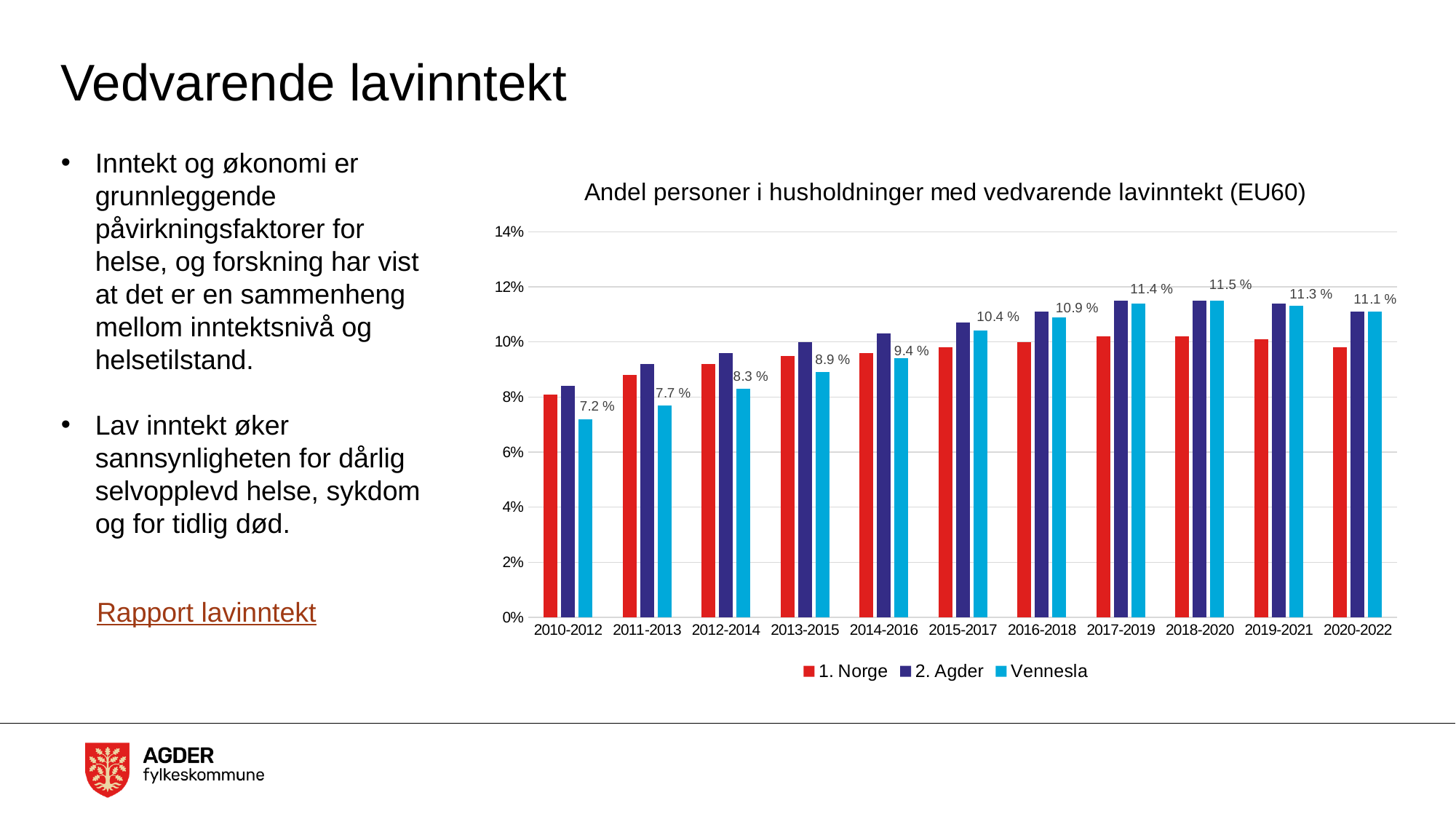
In which period is the Vennesla value highest? 2018-2020 What kind of chart is shown on the slide? bar chart What is the value for Vennesla in 2020-2022? 11.1 % In which period is the Vennesla value lowest? 2010-2012 What is the value for Vennesla in 2016-2018? 10.9 % Is the value for 1. Norge in 2010-2012 greater or less than 10%? less Is the value for 2. Agder in 2020-2022 greater or less than 10%? greater In 2010-2012, which is larger: the value for 1. Norge or the value for Vennesla? 1. Norge How many series does the legend list? 3 How many periods are shown on the x axis? 11 What is the value for Vennesla in 2010-2012? 7.2 % What is the difference between the Vennesla values for 2018-2020 and 2010-2012? 4.3 percentage points